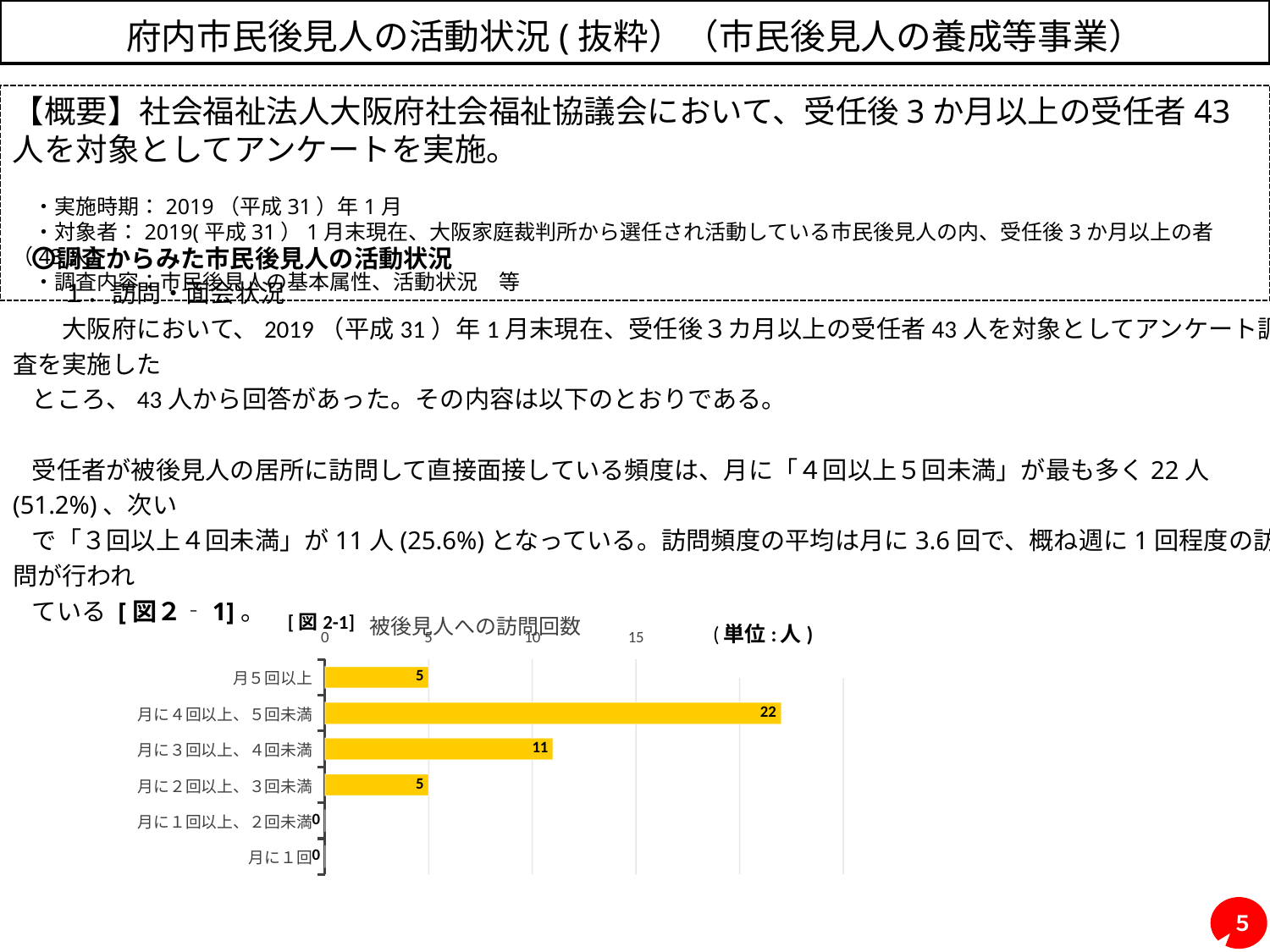
How many categories are shown in the chart 被後見人への訪問回数? 6 What is the value for 月に１回以上、２回未満 in the chart? 0 What is the value for 月に３回以上、４回未満 in the chart? 11 What is the title of the chart on the slide? 被後見人への訪問回数 What is the value for 月５回以上 in the chart? 5 What is the difference between the values for 月に４回以上、５回未満 and 月に３回以上、４回未満? 11 Which is larger: the value for 月に３回以上、４回未満 or the value for 月に２回以上、３回未満? 月に３回以上、４回未満 Which category has the highest value in the chart 被後見人への訪問回数? 月に４回以上、５回未満 What is the value for 月に４回以上、５回未満 in the chart 被後見人への訪問回数? 22 What unit is indicated for the chart values? 人 What type of chart is shown on the slide? bar chart Is the value for 月に４回以上、５回未満 greater or less than 15? greater